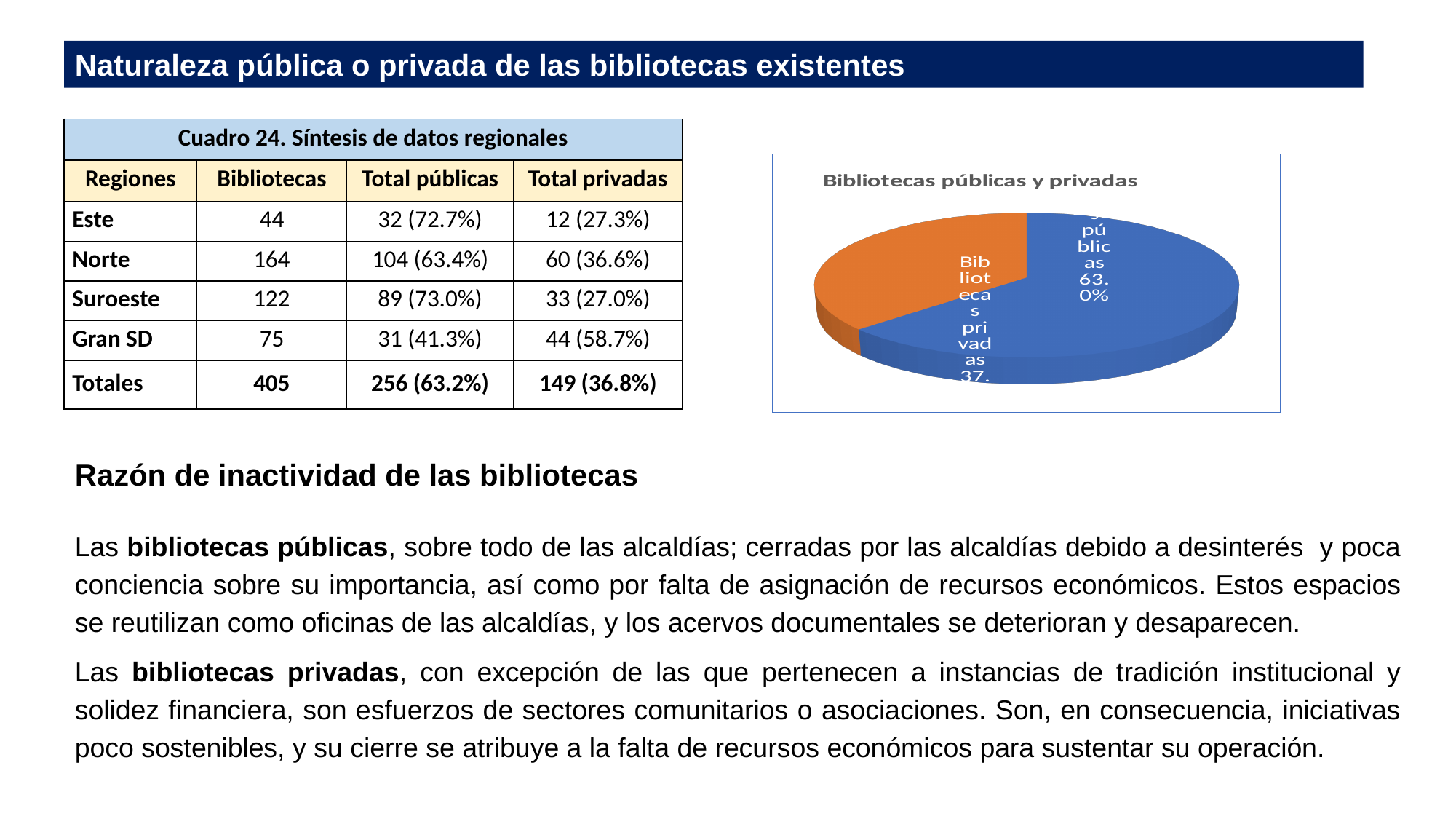
What is the title of the pie chart? Bibliotecas públicas y privadas What share of the pie does Bibliotecas públicas represent? 63.0% Which slice of the pie chart is the smallest? Bibliotecas privadas Which is larger in the pie chart, Bibliotecas públicas or Bibliotecas privadas? Bibliotecas públicas What kind of chart is shown on the slide? pie chart Is the share for Bibliotecas privadas greater or less than 50%? less What colour is the Bibliotecas públicas slice in the pie chart? blue How many slices does the pie chart have? 2 Which slice of the pie chart is the largest? Bibliotecas públicas